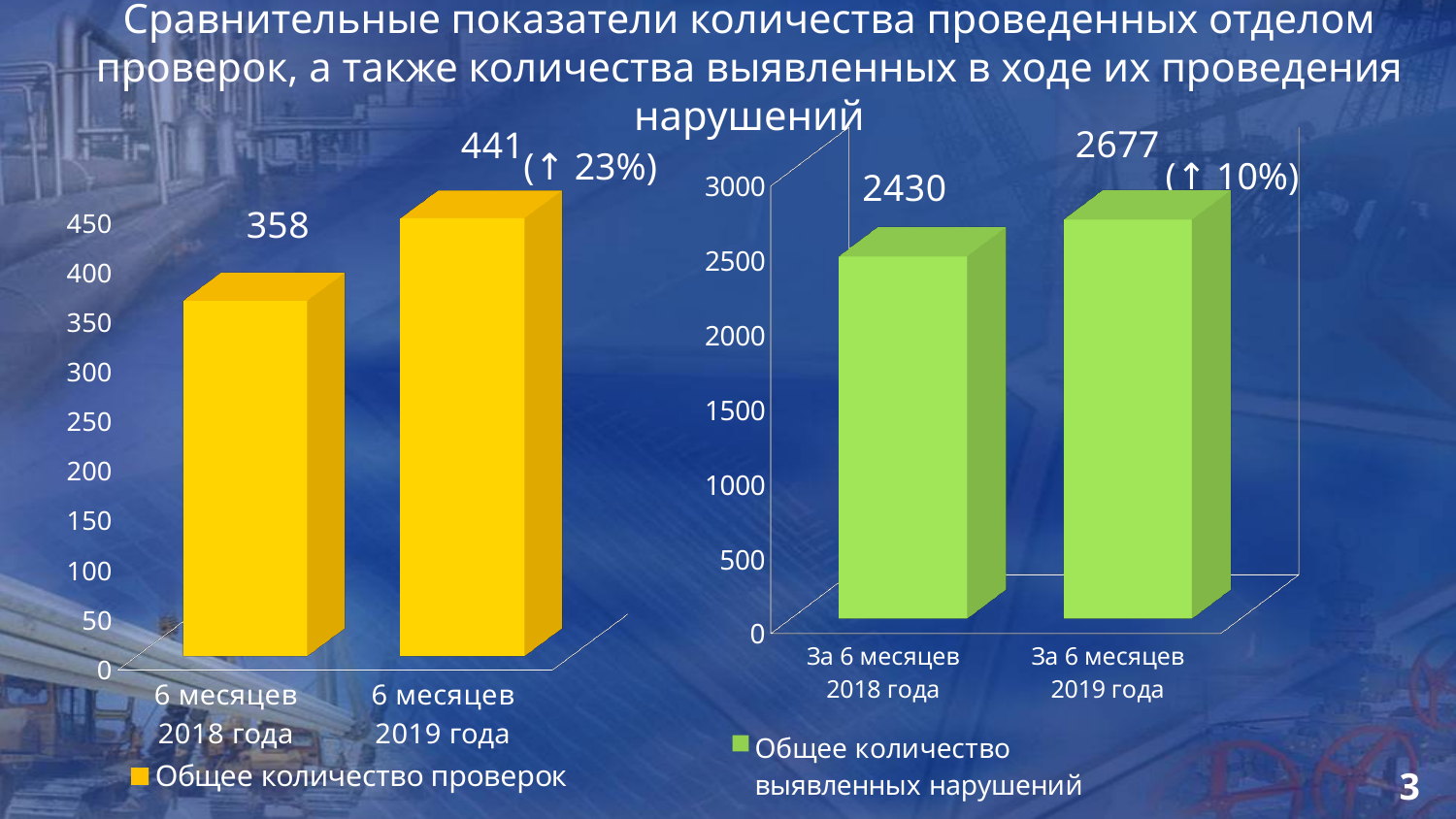
In the right chart (Общее количество выявленных нарушений), what is the value for За 6 месяцев 2018 года? 2430 In the right chart, what is the difference between the values for За 6 месяцев 2019 года and За 6 месяцев 2018 года? 247 What percentage increase is annotated next to the 2019 bar in the left chart? 23% In the left chart, what is the difference between the values for 6 месяцев 2019 года and 6 месяцев 2018 года? 83 How many categories are shown in the left chart? 2 In the right chart, which category has the lowest value? За 6 месяцев 2018 года In the left chart, which category has the highest value? 6 месяцев 2019 года In the right chart (Общее количество выявленных нарушений), what is the value for За 6 месяцев 2019 года? 2677 What kind of chart is the right chart? Bar chart In the left chart (Общее количество проверок), what is the value for 6 месяцев 2018 года? 358 In the right chart, which is larger: the value for За 6 месяцев 2018 года or За 6 месяцев 2019 года? За 6 месяцев 2019 года In the left chart (Общее количество проверок), what is the value for 6 месяцев 2019 года? 441